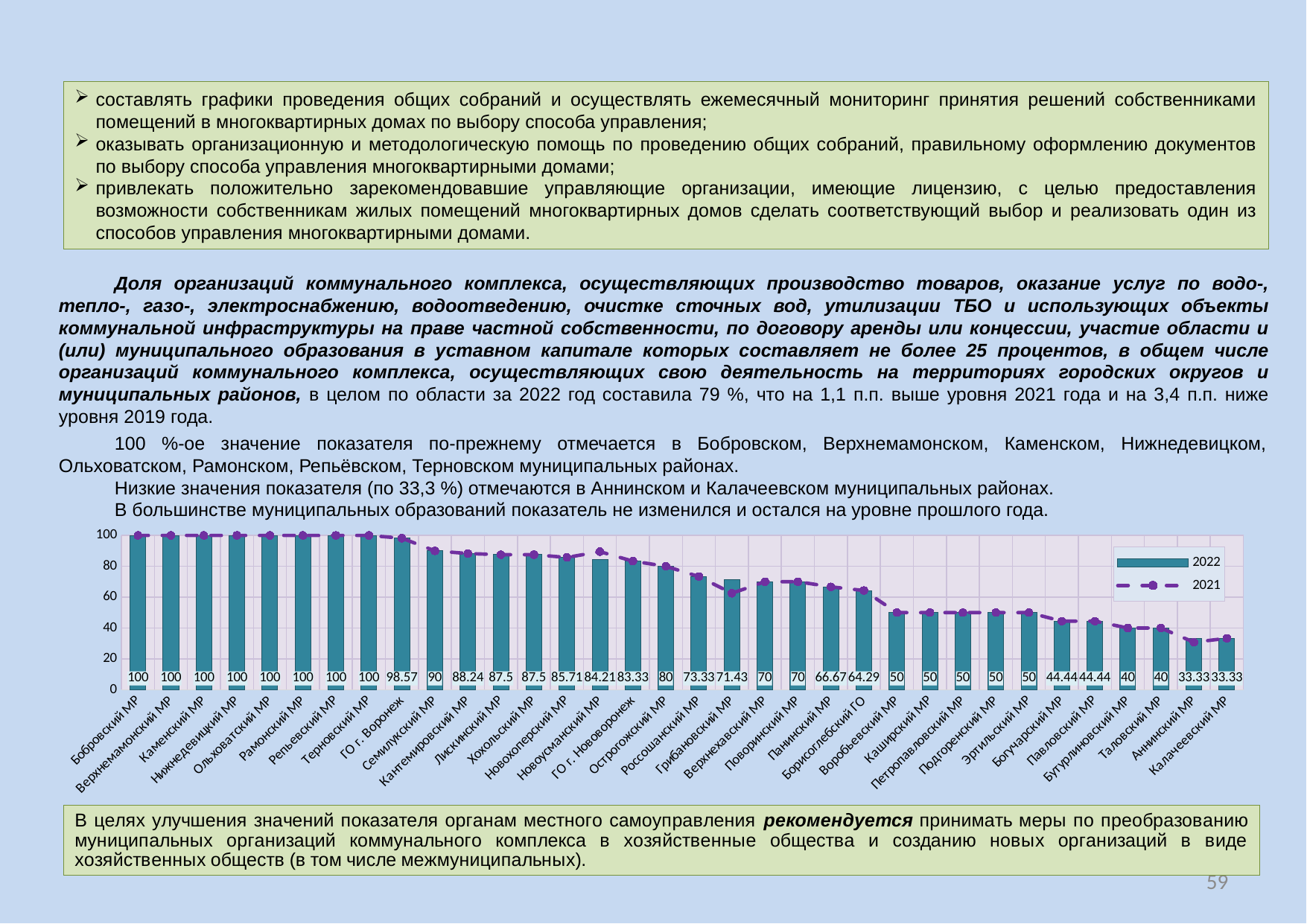
How many series does the chart legend list? 2 Is the 2022 value for Новоусманский МР larger than the 2022 value for Россошанский МР? Yes Do the 2022 values rise or fall from left to right along the x axis? Fall What is the 2022 value for Борисоглебский ГО? 64.29 What is the difference between the 2022 values for Семилукский МР and Острогожский МР? 10 What is the 2022 value for ГО г. Воронеж? 98.57 What kind of chart is shown on the slide? Bar chart with a line series What is the 2022 value for Кантемировский МР? 88.24 Which category has the lowest 2022 value, Аннинский МР or Таловский МР? Аннинский МР How many categories are shown on the x axis of the chart? 34 Is the 2021 value for Грибановский МР greater or less than 80? less What is the 2022 value for Грибановский МР? 71.43